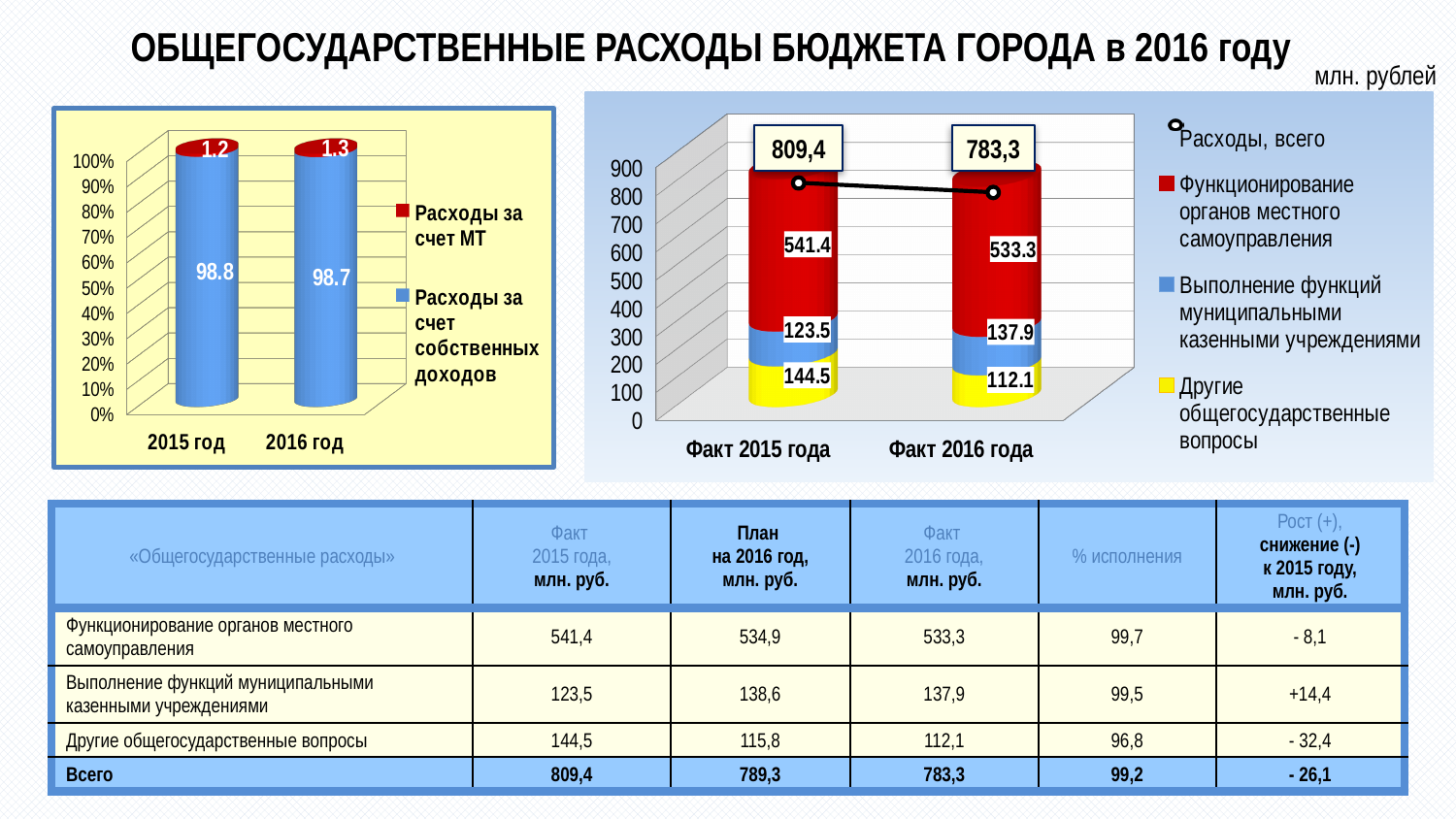
In the right chart, which colour represents 'Другие общегосударственные вопросы'? yellow In the right chart, which is larger: 'Выполнение функций муниципальными казенными учреждениями' in Факт 2015 года or in Факт 2016 года? Факт 2016 года In the right chart, what is the value for 'Функционирование органов местного самоуправления' in Факт 2015 года? 541.4 In the left chart, how many categories are shown on the x axis? 2 In the right chart, what is the value for 'Другие общегосударственные вопросы' in Факт 2016 года? 112.1 In the left chart, what is the value for 'Расходы за счет МТ' in 2016 год? 1.3 In the right chart, what is the difference between 'Расходы, всего' for Факт 2015 года and Факт 2016 года? 26,1 In the right chart, how many series does the legend list? 4 In the left chart, what is the value for 'Расходы за счет собственных доходов' in 2015 год? 98.8 In the left chart, how many series does the legend list? 2 In the right chart, what is the value of 'Расходы, всего' for Факт 2016 года? 783,3 In the right chart, does the 'Расходы, всего' line rise or fall from Факт 2015 года to Факт 2016 года? fall